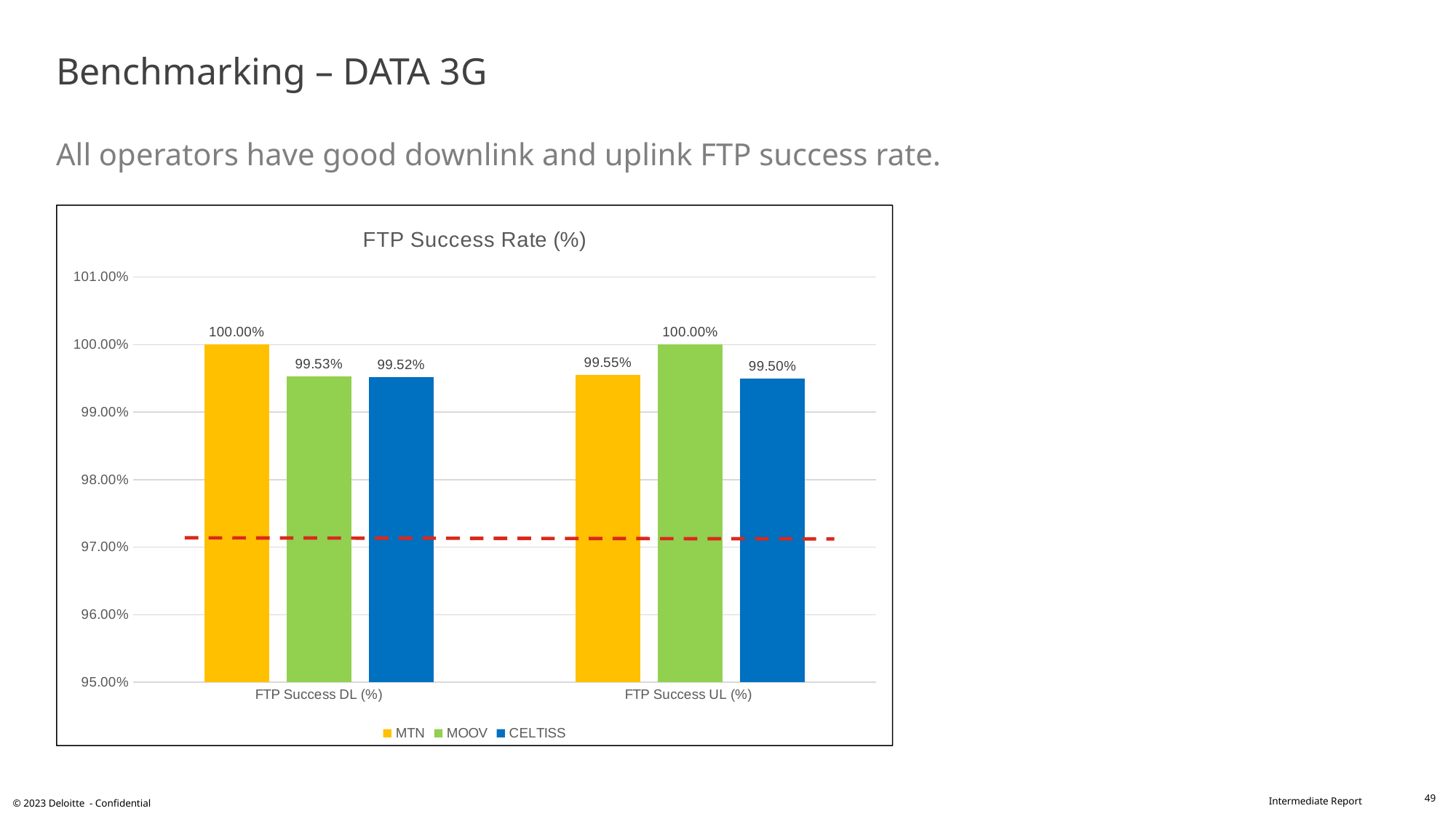
What is the difference between MTN's and CELTISS's FTP Success DL (%) values? 0.48% What kind of chart is shown on the slide? Bar chart How many series does the legend list? 3 What is the FTP Success UL (%) value for CELTISS? 99.50% What is the title of the chart? FTP Success Rate (%) Which is larger: MTN's FTP Success DL (%) or MTN's FTP Success UL (%)? FTP Success DL (%) What is the FTP Success UL (%) value for MTN? 99.55% What is the FTP Success DL (%) value for MTN? 100.00% What is the difference between MOOV's and MTN's FTP Success UL (%) values? 0.45% Which operator has the highest FTP Success UL (%)? MOOV Which operator has the highest FTP Success DL (%)? MTN What is the FTP Success DL (%) value for MOOV? 99.53%